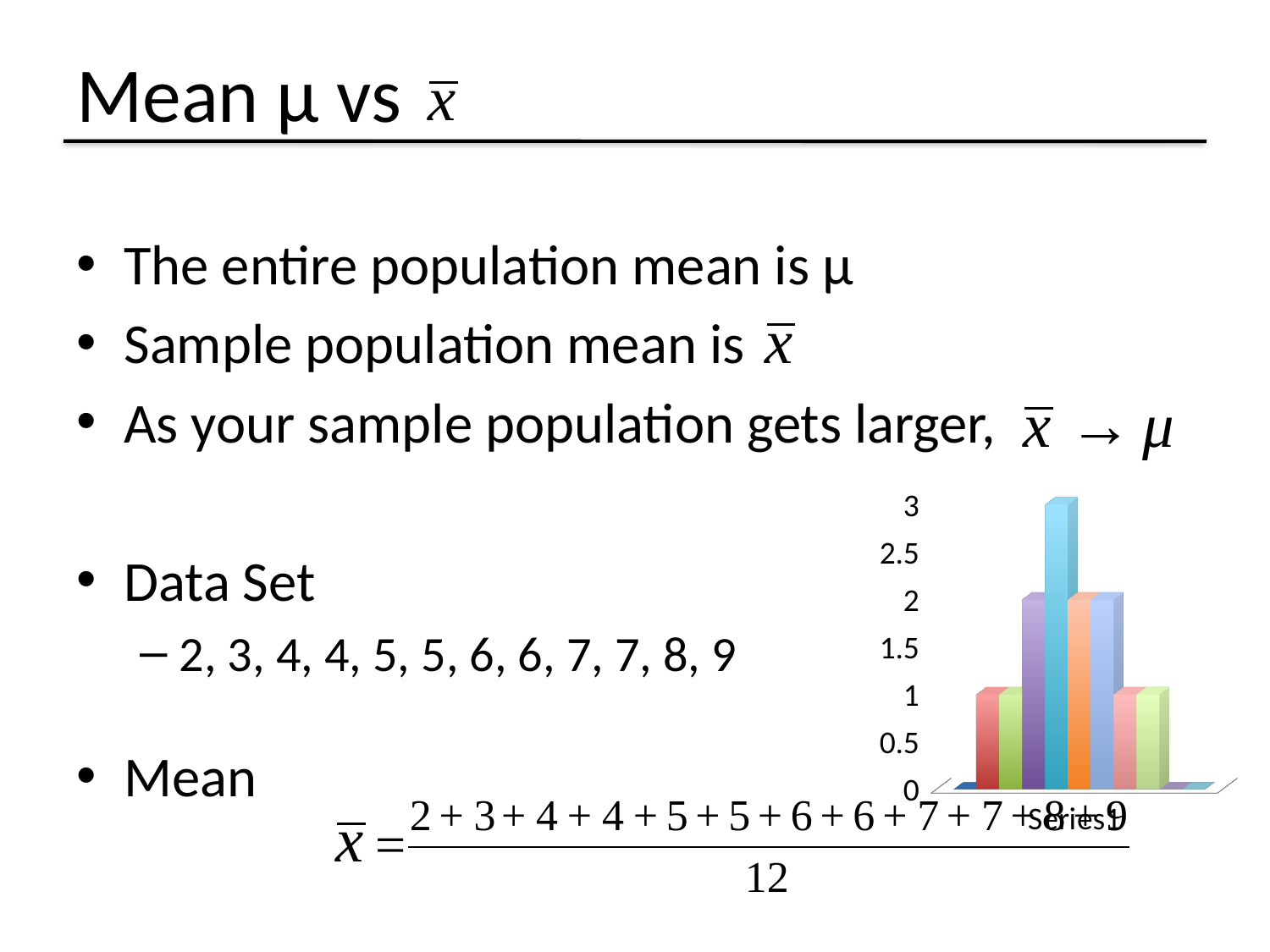
Is the value of the red bar at the left of the chart greater or less than 1.5? less How many bars in the chart reach a height of 1? 4 How many bars in the chart reach a height of 2? 3 What kind of chart is shown on the slide? bar chart Is the value of the tallest bar in the chart greater or less than 2.5? greater What series name is printed below the chart's horizontal axis? Series1 What is the interval between consecutive tick marks on the chart's vertical axis? 0.5 Is the value of the purple bar in the chart greater or less than 1.5? greater Which is larger in the chart: the light blue bar or the orange bar? the light blue bar What is the highest tick value shown on the vertical axis of the chart? 3 What value does the tallest bar in the chart reach? 3